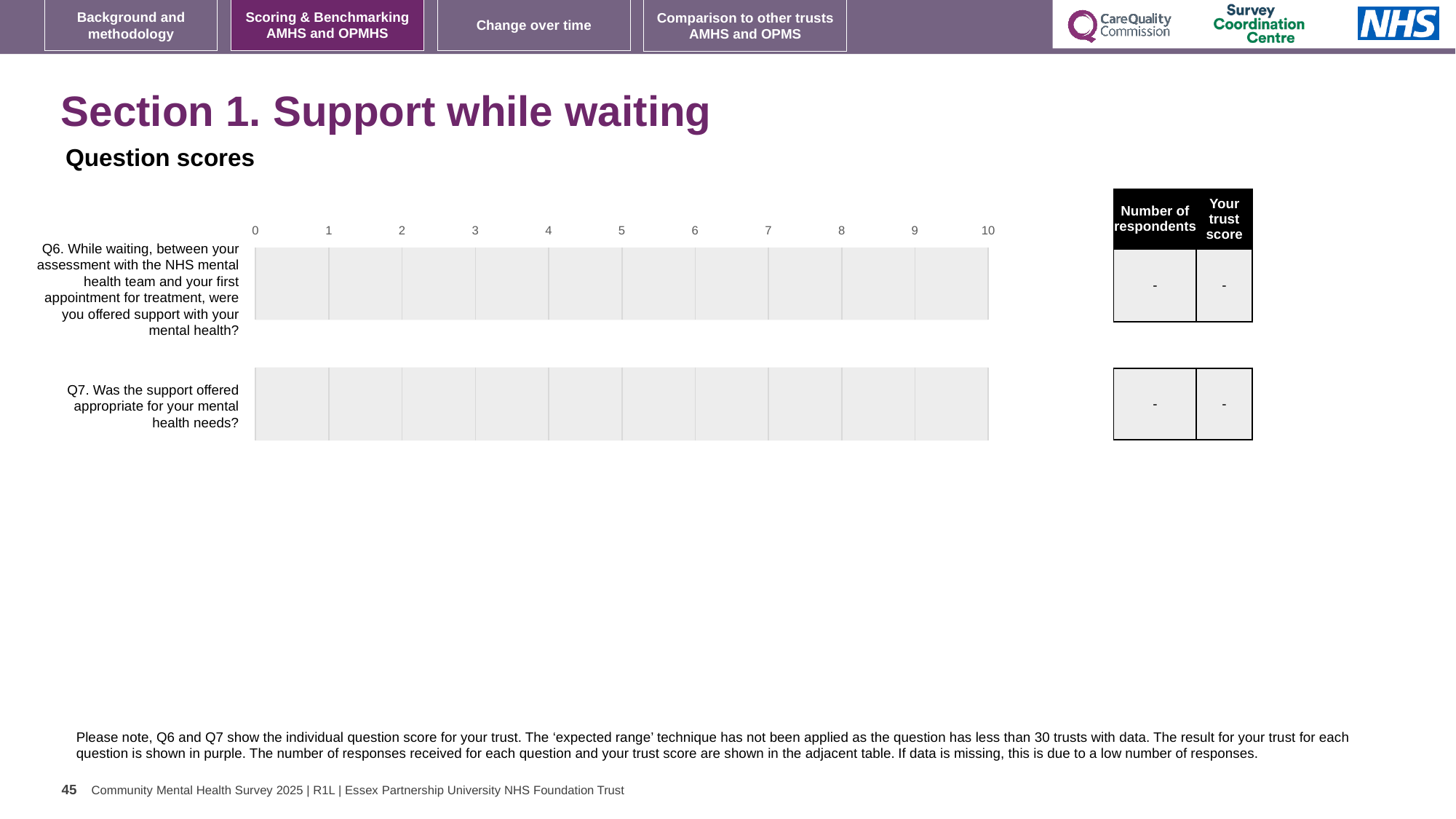
How many questions (categories) are shown on the chart? 2 What is shown in the 'Number of respondents' column for Q7? - What is the lowest value shown on the chart's horizontal axis? 0 What kind of chart is used for the question scores? bar chart What is shown in the 'Your trust score' column for Q6? - What is the highest value shown on the chart's horizontal axis? 10